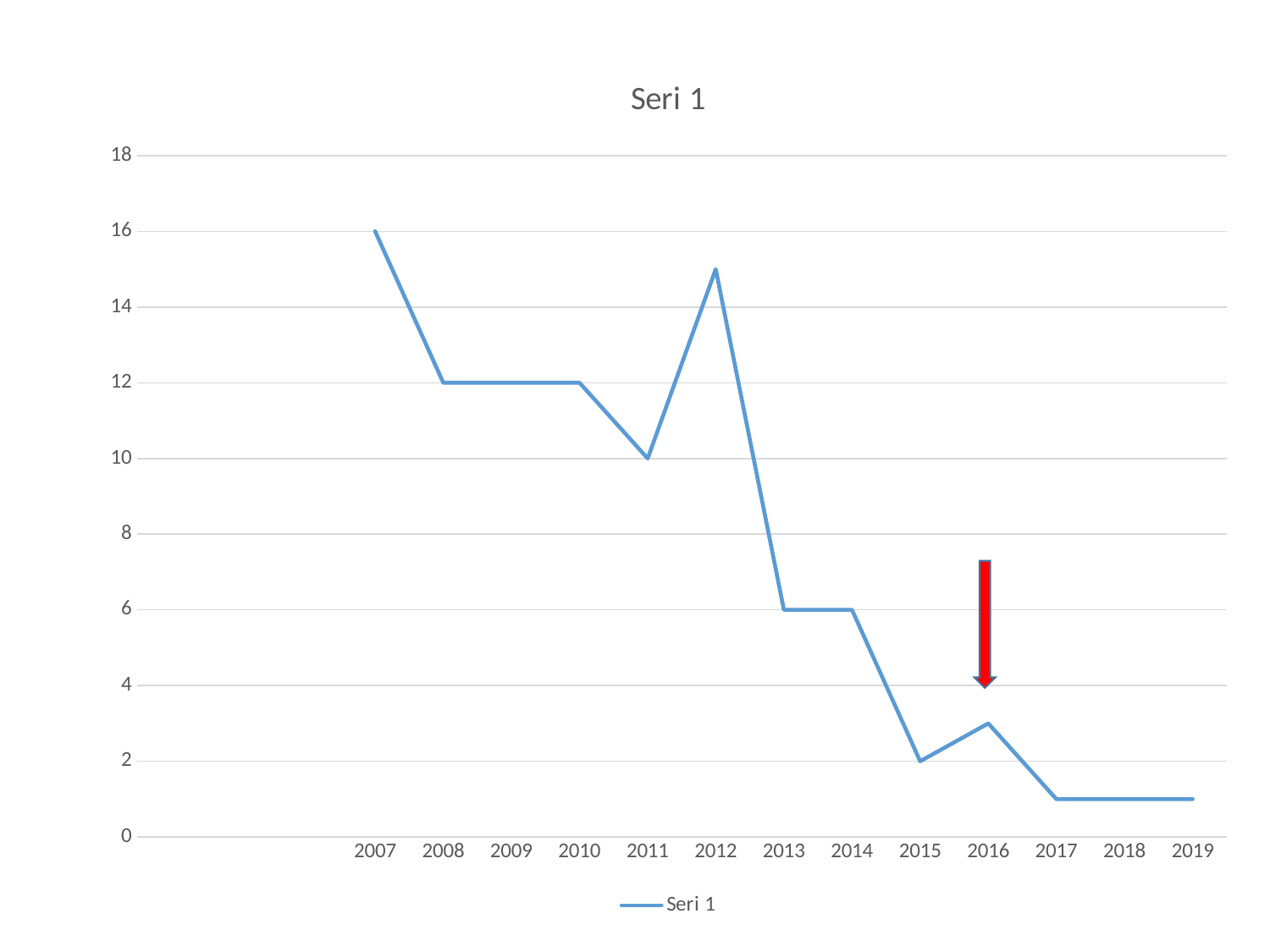
What type of chart is shown on the slide? line chart What is the value for 2015? 2 Which is larger, the value for 2011 or the value for 2013? 2011 What is the value for 2011? 10 What is the value for 2013? 6 Is the value for 2016 greater or less than 4? less What is the value for 2007? 16 Is the value for 2012 greater or less than 14? greater What is the value for 2008? 12 What is the difference between the values for 2007 and 2008? 4 Which year has the highest value? 2007 How many years are plotted on the x axis? 13